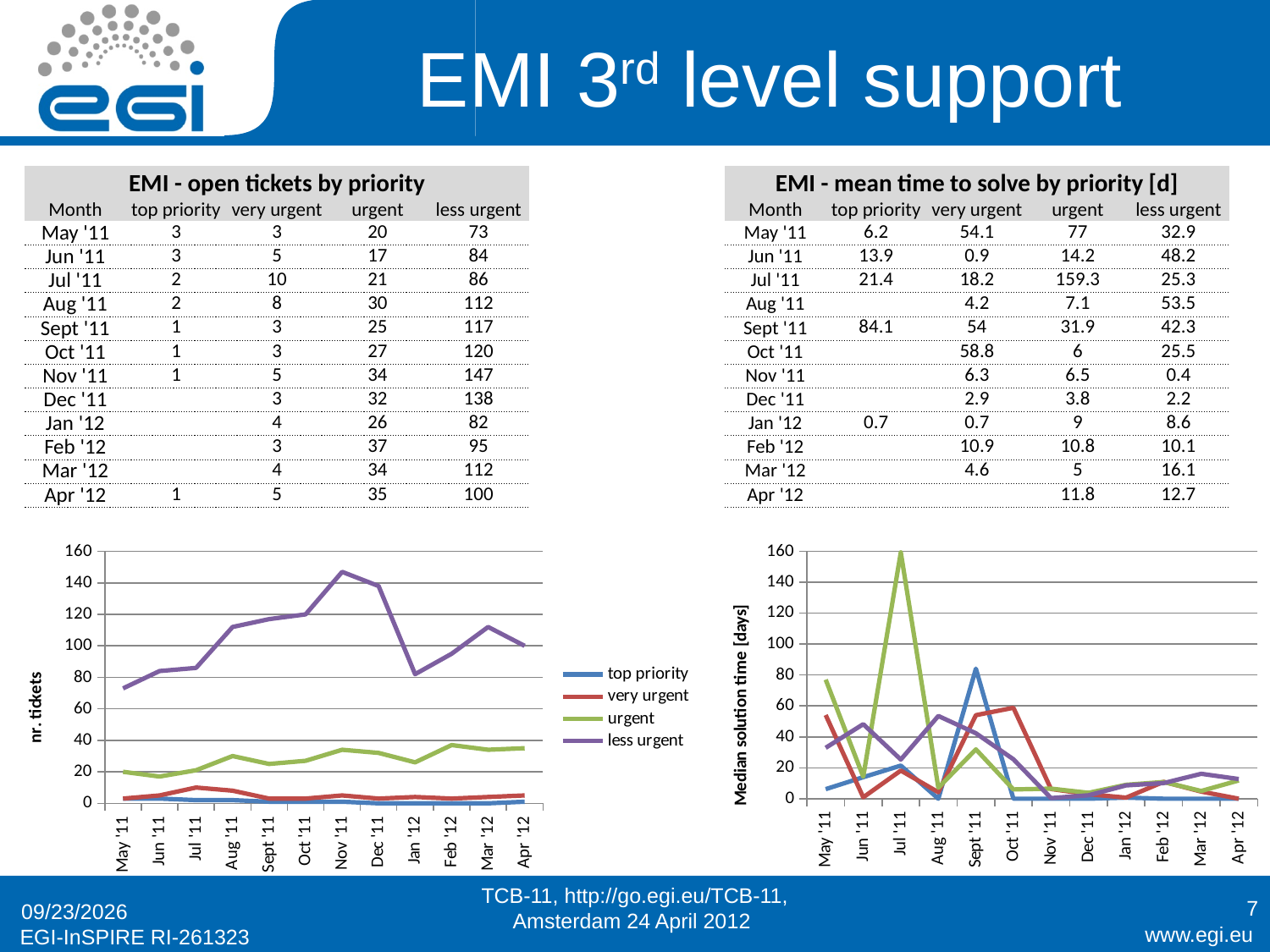
In the right chart (mean time to solve by priority), what is the value for top priority in Sept '11? 84.1 In the right chart (mean time to solve by priority), which month has the highest value for urgent? Jul '11 In the left chart (open tickets by priority), what is the value for less urgent in Nov '11? 147 In the left chart (open tickets by priority), does the less urgent line rise or fall from May '11 to Nov '11? rises In the left chart (open tickets by priority), which month has the lowest number of less urgent tickets? May '11 How many series does the legend of the left chart list? 4 In the left chart (open tickets by priority), which month has the highest number of less urgent tickets? Nov '11 What kind of chart is the left chart (open tickets by priority)? line chart In the left chart (open tickets by priority), is the less urgent value for Aug '11 greater or less than 100? greater What is the y-axis label of the right chart? Median solution time [days] In the left chart (open tickets by priority), what is the difference between the less urgent values for Nov '11 and Dec '11? 9 How many months are plotted along the x axis of the left chart? 12